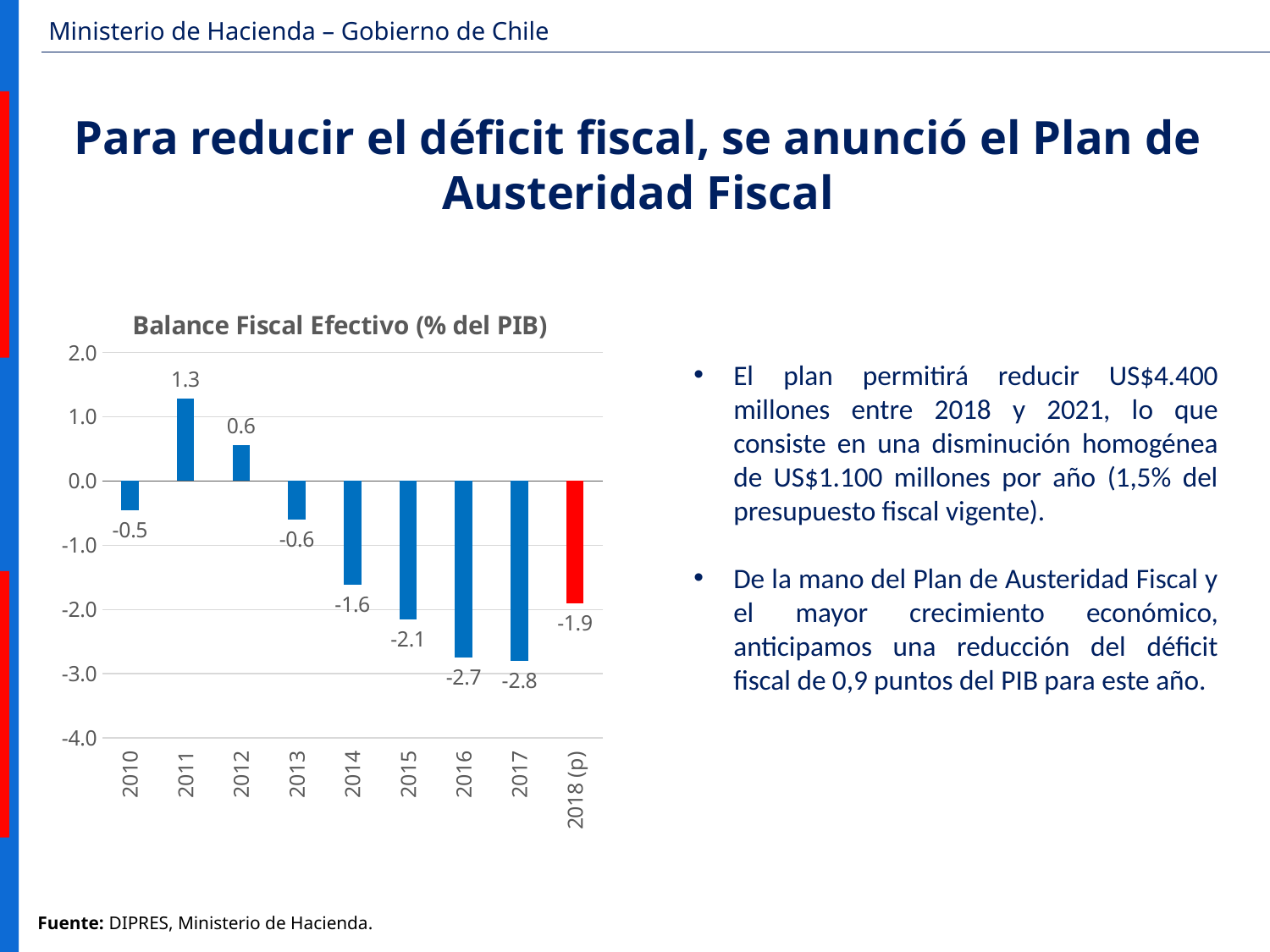
What kind of chart is the Balance Fiscal Efectivo chart? bar chart What is the difference between the values for 2016 and 2017 in the Balance Fiscal Efectivo chart? 0.1 What is the value for 2018 (p) in the Balance Fiscal Efectivo chart? -1.9 Which year has the lowest value in the Balance Fiscal Efectivo chart? 2017 What is the value for 2011 in the Balance Fiscal Efectivo chart? 1.3 Do the values in the Balance Fiscal Efectivo chart rise or fall from 2013 to 2017? fall What is the value for 2017 in the Balance Fiscal Efectivo chart? -2.8 Is the value for 2015 in the Balance Fiscal Efectivo chart greater or less than -2.0? less Which year has the highest value in the Balance Fiscal Efectivo chart? 2011 Which is larger in the Balance Fiscal Efectivo chart, the value for 2014 or the value for 2015? 2014 How many years are shown on the x axis of the Balance Fiscal Efectivo chart? 9 Which bar in the Balance Fiscal Efectivo chart is coloured red instead of blue? 2018 (p)